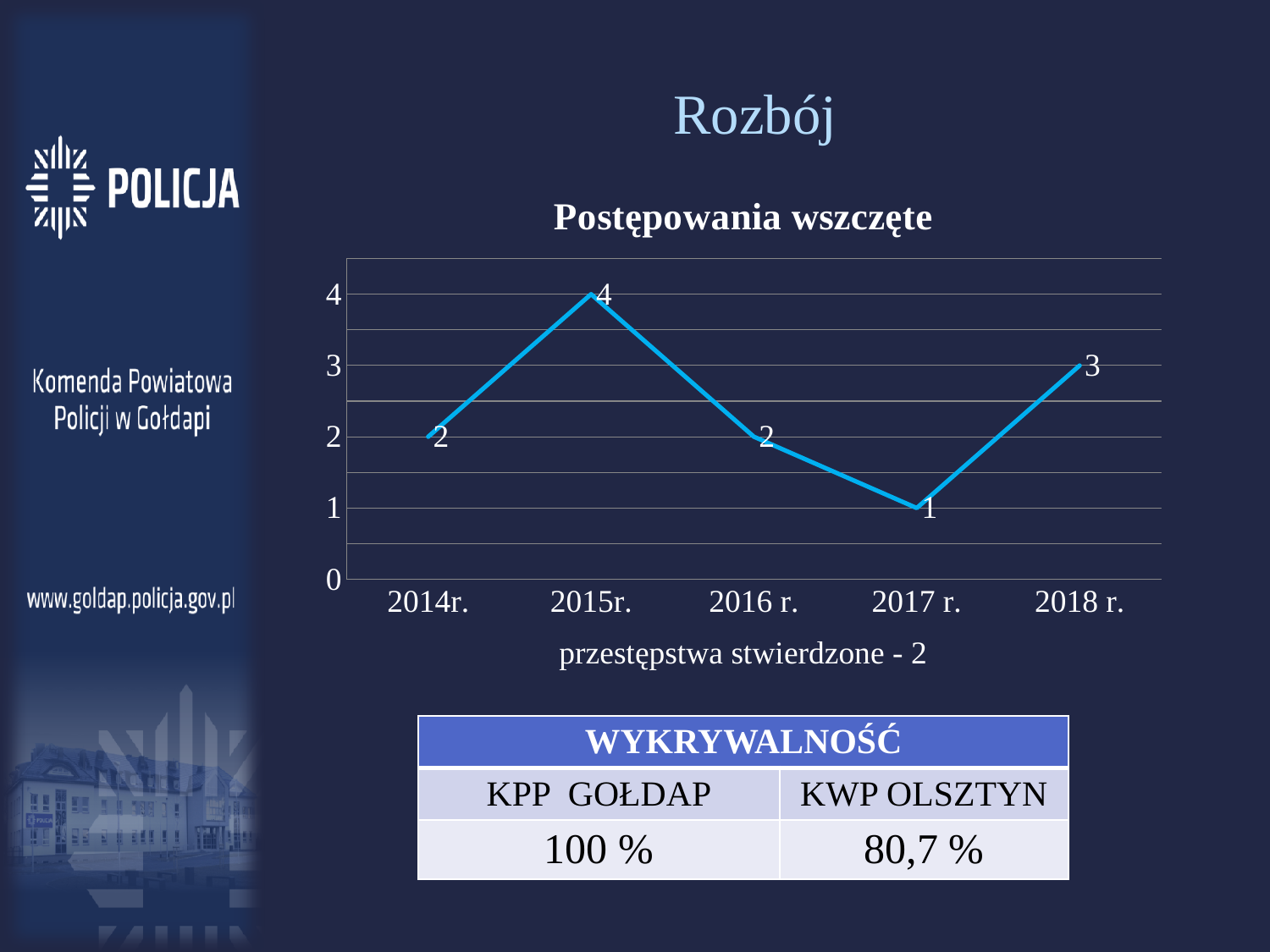
How many years are plotted in the Postępowania wszczęte chart? 5 Does the value rise or fall from 2017 r. to 2018 r. in the Postępowania wszczęte chart? rise What is the legend entry shown below the Postępowania wszczęte chart? przestępstwa stwierdzone - 2 Which year has the lowest value in the Postępowania wszczęte chart? 2017 r. What is the difference between the values for 2015r. and 2017 r. in the Postępowania wszczęte chart? 3 What is the value for 2018 r. in the Postępowania wszczęte chart? 3 What is the title of the chart on the slide? Postępowania wszczęte What is the value for 2017 r. in the Postępowania wszczęte chart? 1 What is the value for 2015r. in the Postępowania wszczęte chart? 4 Which year has the highest value in the Postępowania wszczęte chart? 2015r. What kind of chart is the Postępowania wszczęte chart? line chart Which is larger in the Postępowania wszczęte chart, the value for 2016 r. or the value for 2018 r.? 2018 r.